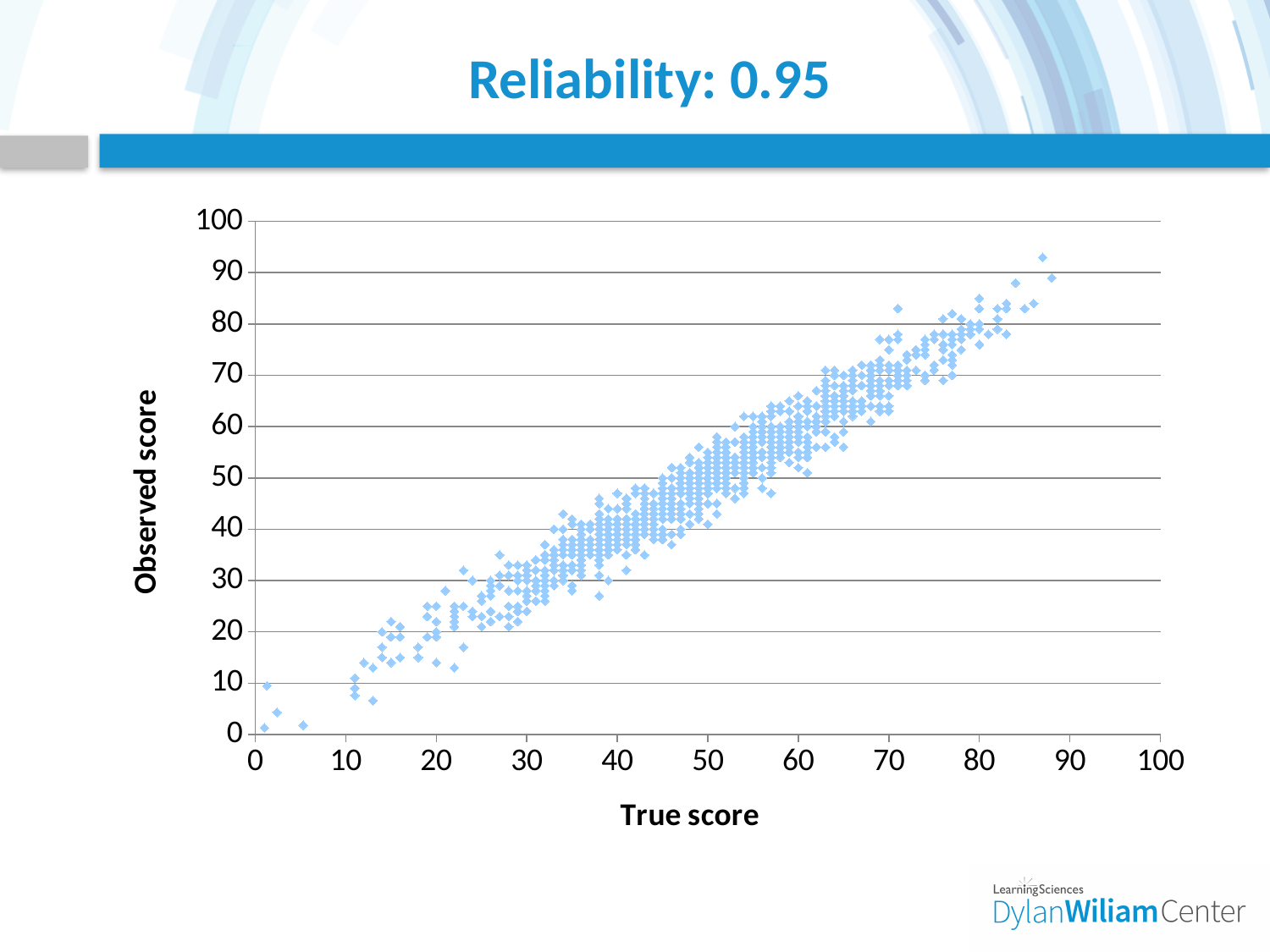
What is the maximum value shown on the x axis (True score)? 100 What is the interval between consecutive tick marks on the y axis? 10 What is the label of the x axis? True score What kind of chart is shown on the slide? scatter plot Is the largest true score plotted greater or less than 90? less What is the title of the slide's chart? Reliability: 0.95 As the true score increases along the x axis, do the observed scores generally rise or fall? rise Is the lowest observed score plotted greater or less than 10? less What is the maximum value shown on the y axis (Observed score)? 100 Is the highest observed score plotted greater or less than 90? greater